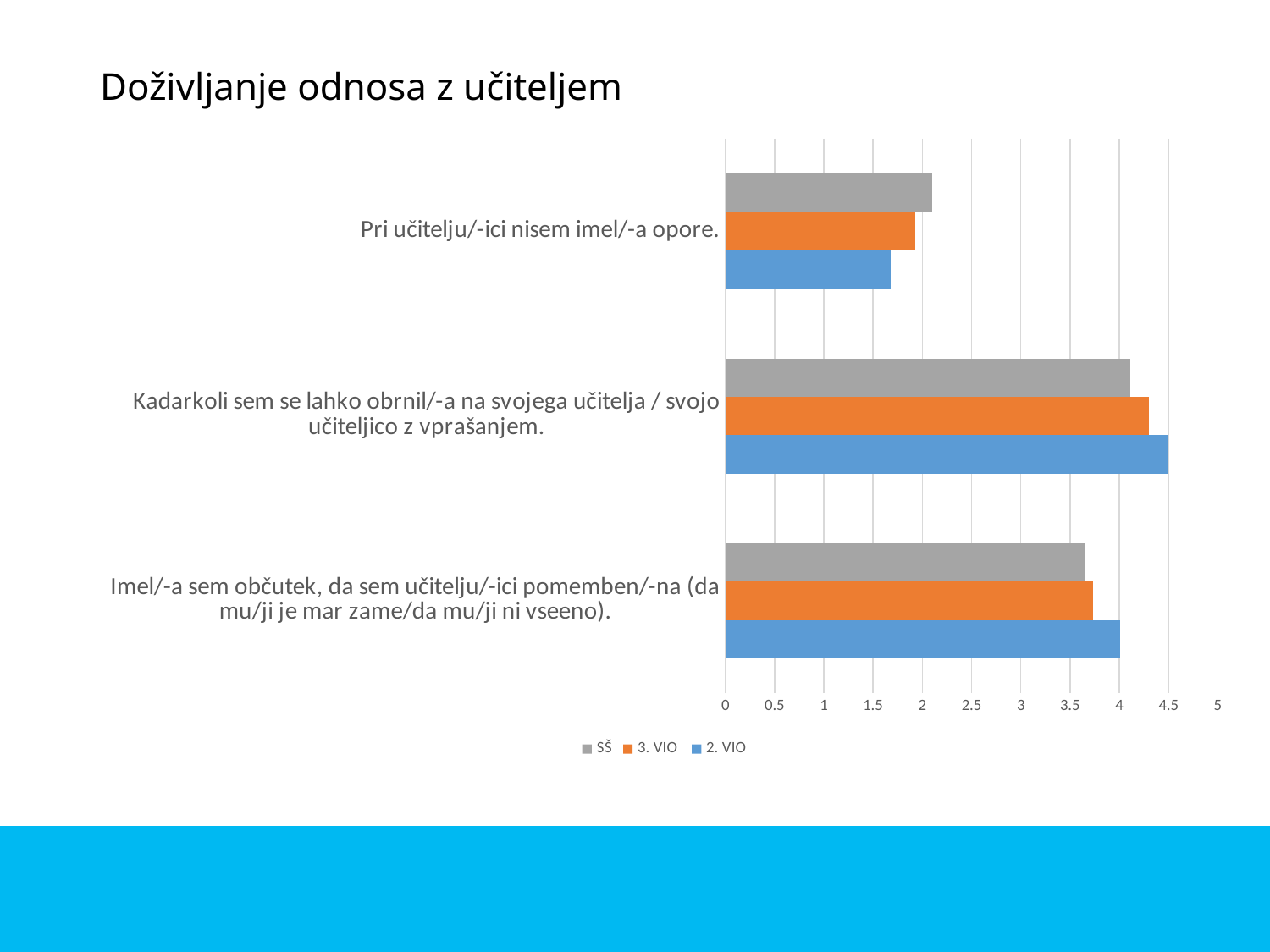
For "Pri učitelju/-ici nisem imel/-a opore.", which series has the lowest value? 2. VIO Is the 3. VIO value for "Kadarkoli sem se lahko obrnil/-a na svojega učitelja / svojo učiteljico z vprašanjem." greater or less than 4? greater Is the 2. VIO value for "Kadarkoli sem se lahko obrnil/-a na svojega učitelja / svojo učiteljico z vprašanjem." greater or less than 4? greater Which series are listed in the legend? SŠ, 3. VIO, 2. VIO For "Pri učitelju/-ici nisem imel/-a opore.", which is larger: the SŠ value or the 2. VIO value? SŠ What kind of chart is shown on the slide? bar chart Is the 2. VIO value for "Pri učitelju/-ici nisem imel/-a opore." greater or less than 2? less How many categories (statements) are plotted on the chart? 3 What is the title of the slide containing the chart? Doživljanje odnosa z učiteljem How many series does the legend list? 3 For "Kadarkoli sem se lahko obrnil/-a na svojega učitelja / svojo učiteljico z vprašanjem.", which series has the highest value? 2. VIO